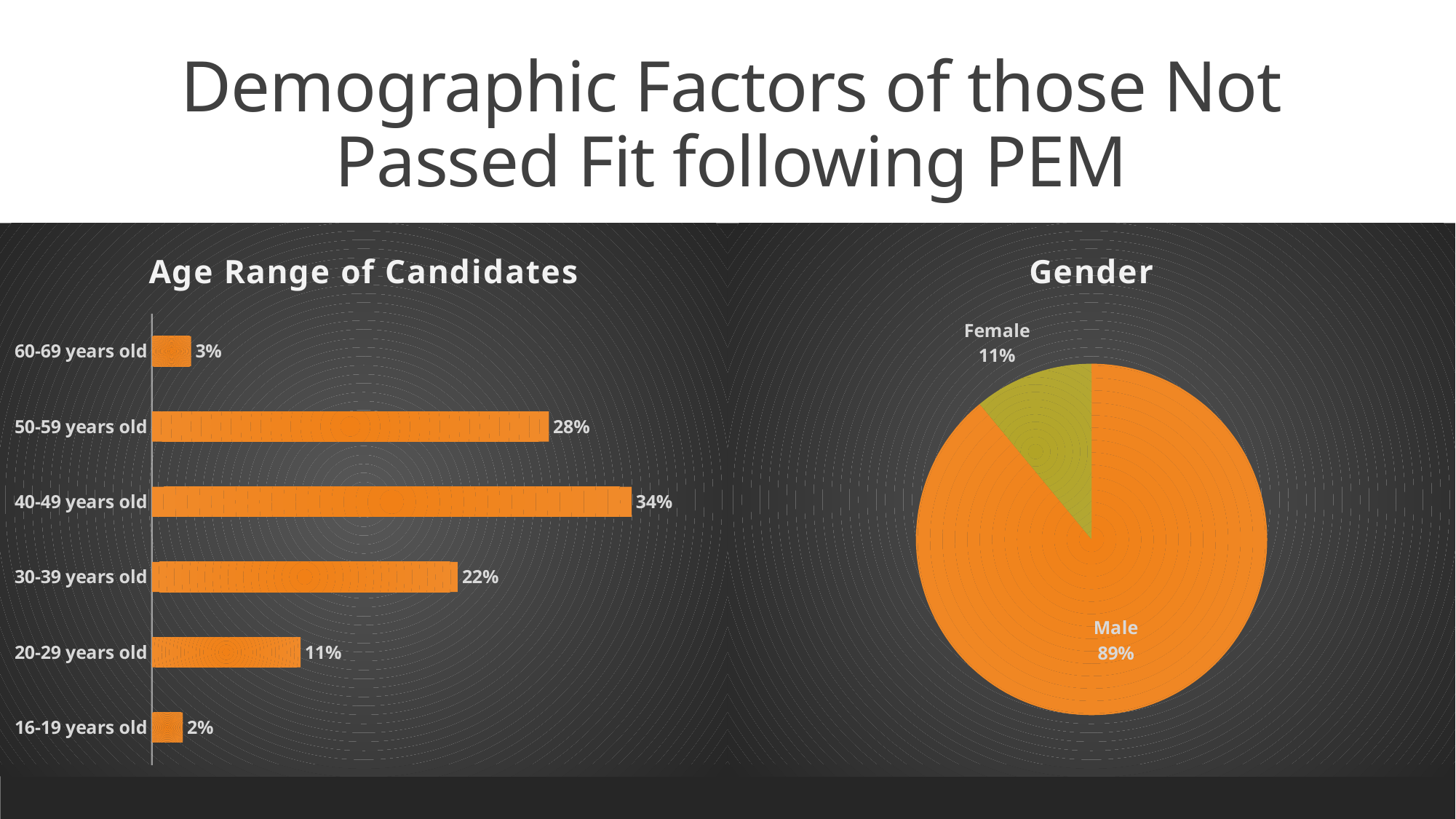
What kind of chart is the 'Gender' chart? Pie chart In the 'Age Range of Candidates' chart, which is larger, the value for 60-69 years old or 16-19 years old? 60-69 years old In the 'Gender' chart, what is the value for Male? 89% In the 'Age Range of Candidates' chart, which age range has the lowest value? 16-19 years old In the 'Age Range of Candidates' chart, what is the value for 20-29 years old? 11% In the 'Age Range of Candidates' chart, what is the value for 40-49 years old? 34% How many slices does the 'Gender' pie chart have? 2 In the 'Age Range of Candidates' chart, what is the difference between the values for 50-59 years old and 30-39 years old? 6% In the 'Gender' chart, what share of the pie is Female? 11% What kind of chart is the 'Age Range of Candidates' chart? Bar chart How many age range categories are shown in the 'Age Range of Candidates' chart? 6 In the 'Age Range of Candidates' chart, which age range has the highest value? 40-49 years old